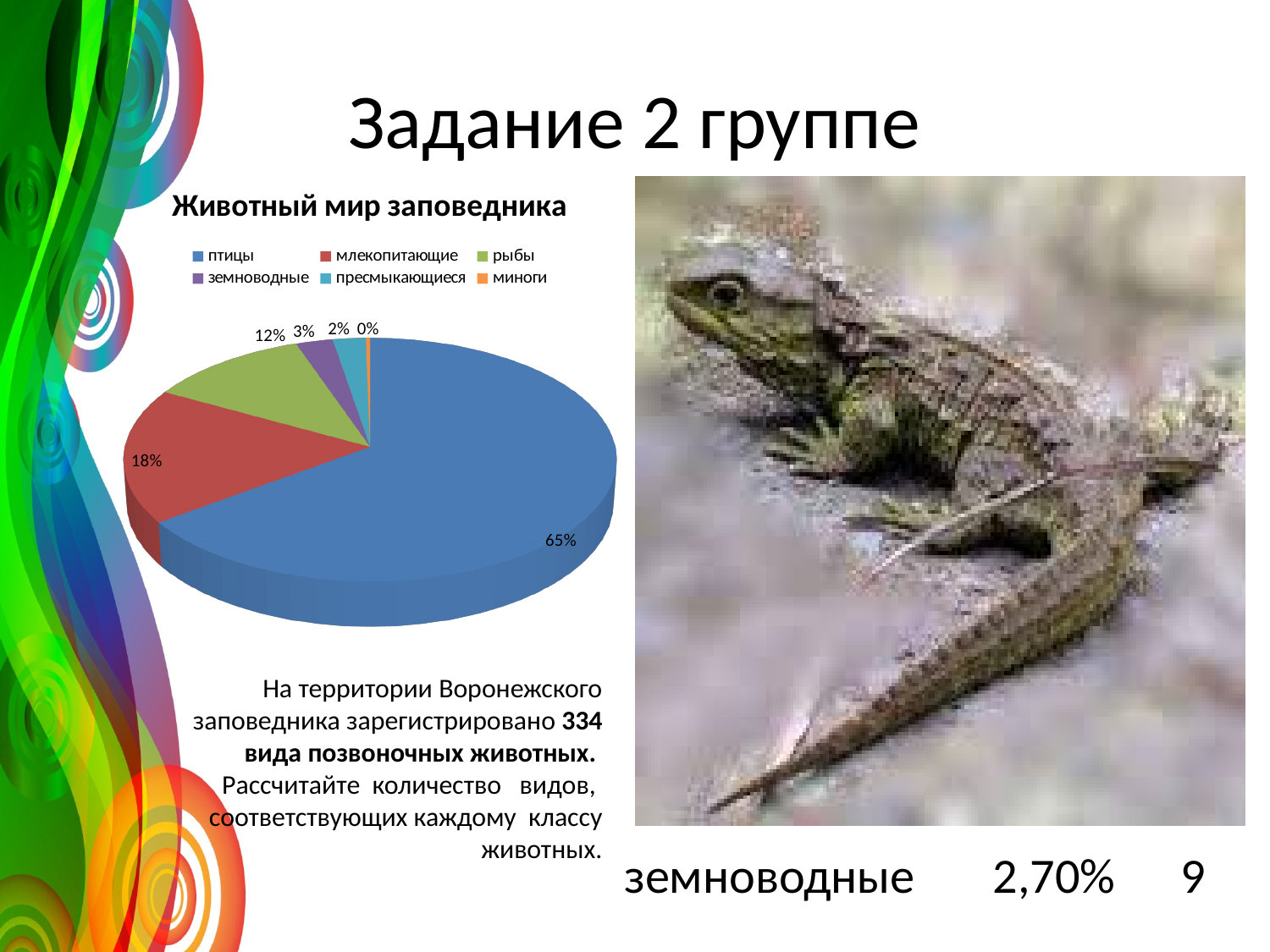
What share of the pie does пресмыкающиеся take? 2% What kind of chart is shown on the slide? pie chart Which category has the largest slice of the pie? птицы What is the title of the chart? Животный мир заповедника How many categories does the chart's legend list? 6 What share of the pie does земноводные take? 3% What is the difference in percentage points between птицы and млекопитающие? 47 Which category has the smallest slice of the pie? миноги What share of the pie does птицы take? 65% Which slice is larger, рыбы or земноводные? рыбы